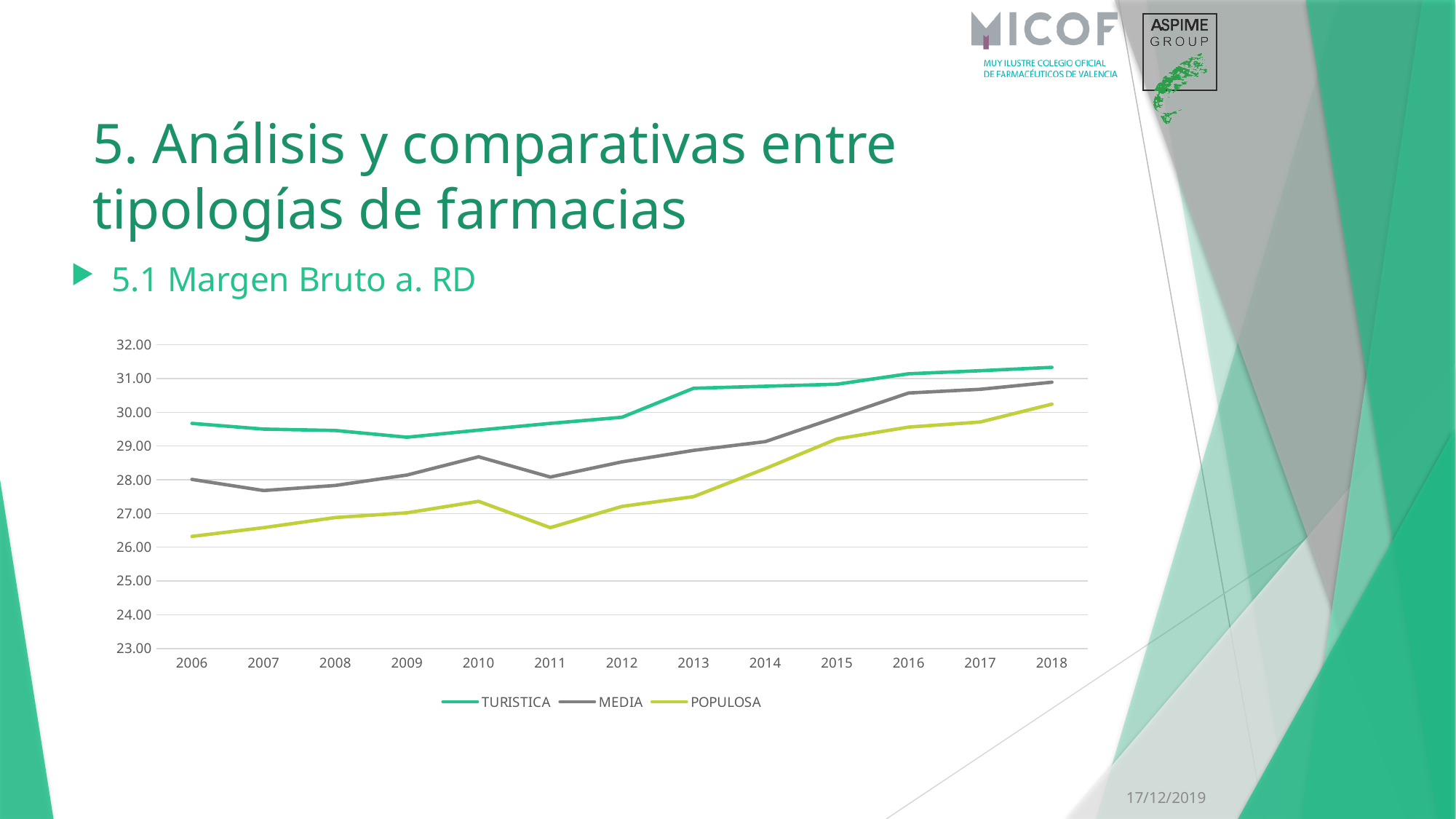
In 2018, which is larger: the value for TURISTICA or the value for POPULOSA? TURISTICA Which series has the lowest value in 2006? POPULOSA Is the value for MEDIA in 2006 greater or less than 29.00? less Does the POPULOSA line rise or fall from 2014 to 2018? rise How many series does the legend list? 3 Is the value for MEDIA in 2016 greater or less than 30.00? greater Is the value for POPULOSA in 2006 greater or less than 27.00? less Which series has the highest value in 2012? TURISTICA How many years are shown on the x axis? 13 What is the subtitle shown above the chart? 5.1 Margen Bruto a. RD What kind of chart is shown on the slide? line chart